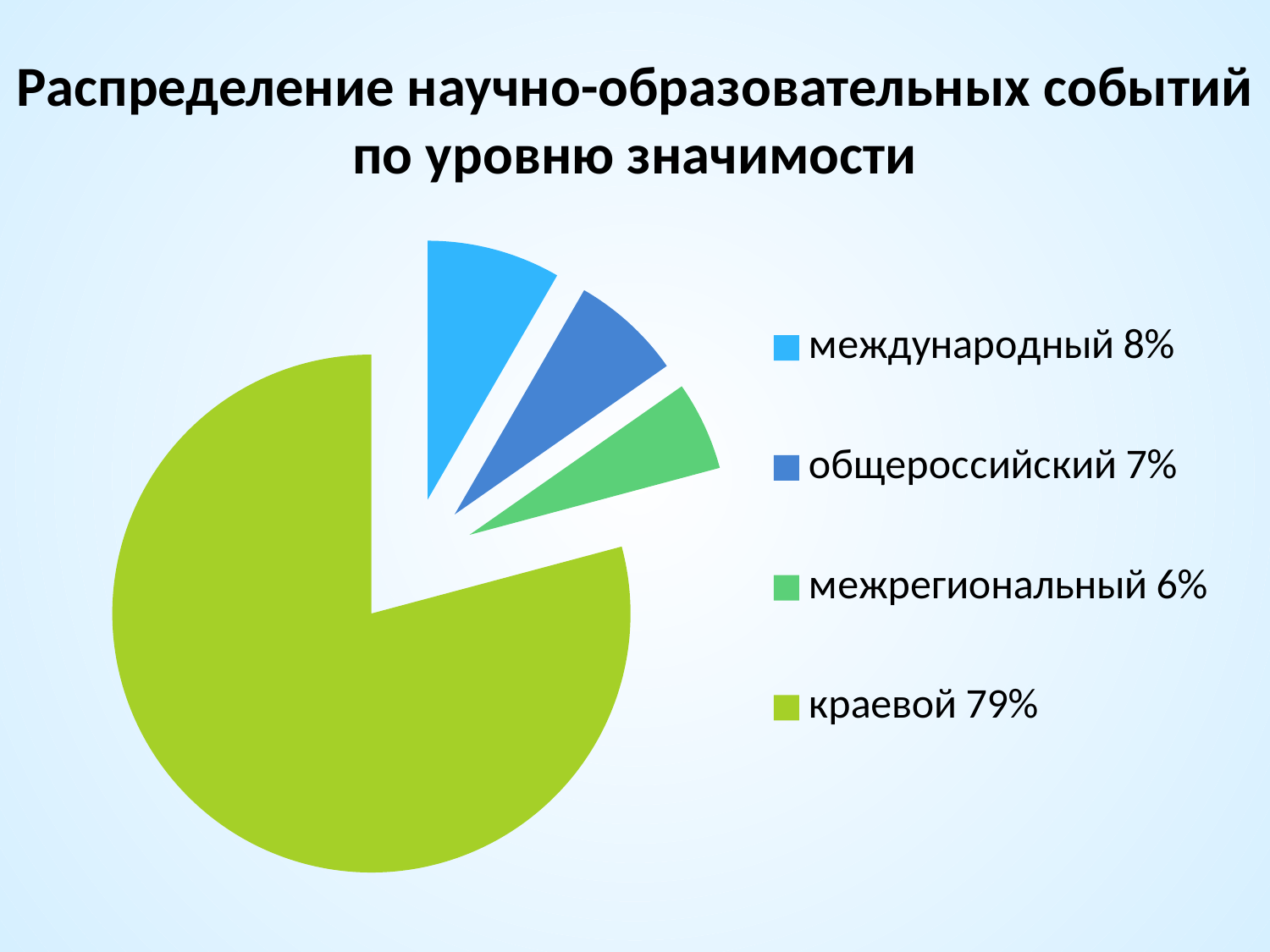
Which is larger, the share for 'международный' or for 'общероссийский'? международный What share of the pie does the 'межрегиональный' slice represent? 6% What share of the pie does the 'международный' slice represent? 8% What colour is the 'краевой' slice? green Which category has the smallest slice of the pie? межрегиональный How many categories does the pie chart show? 4 What is the difference in percentage points between 'международный' and 'межрегиональный'? 2 What kind of chart is shown on the slide? pie chart What is the difference in percentage points between 'краевой' and 'международный'? 71 What share of the pie does the 'общероссийский' slice represent? 7% Which category has the largest slice of the pie? краевой